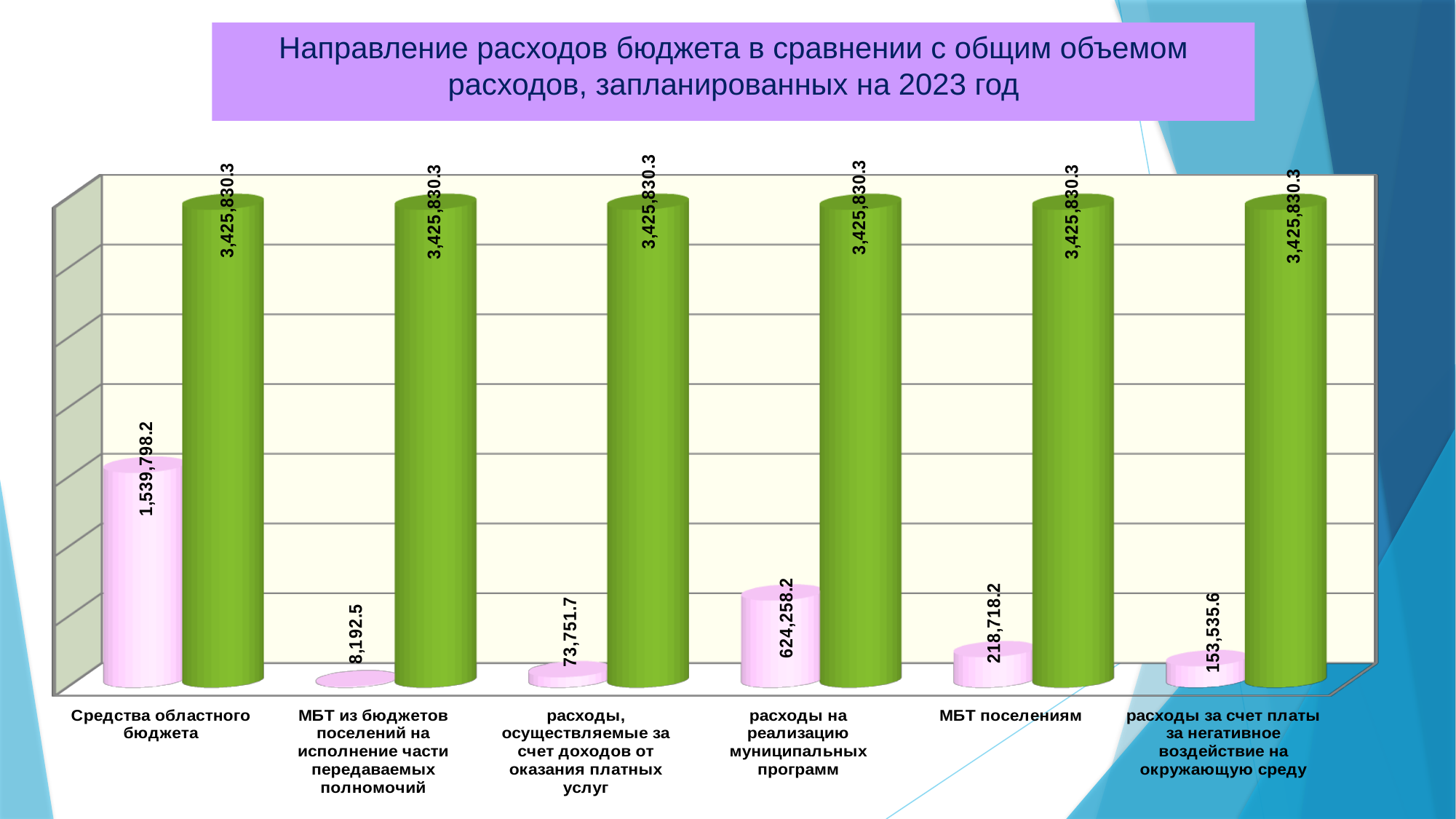
What value is shown on the green bar for "МБТ из бюджетов поселений на исполнение части передаваемых полномочий"? 3,425,830.3 What is the difference between the green bar and the pink bar for "Средства областного бюджета"? 1,886,032.1 Which pink bar is larger: "МБТ поселениям" or "расходы, осуществляемые за счет доходов от оказания платных услуг"? МБТ поселениям What is the value of the pink bar for "расходы за счет платы за негативное воздействие на окружающую среду"? 153,535.6 What is the value of the pink bar for "МБТ поселениям"? 218,718.2 What is the difference between the pink bars for "расходы на реализацию муниципальных программ" and "МБТ поселениям"? 405,540.0 Which category has the lowest pink bar? МБТ из бюджетов поселений на исполнение части передаваемых полномочий What is the value of the pink bar for "Средства областного бюджета"? 1,539,798.2 What is the value of the pink bar for "расходы на реализацию муниципальных программ"? 624,258.2 Which category has the highest pink bar? Средства областного бюджета How many categories are shown on the x axis of the chart? 6 What kind of chart is shown on the slide? Bar chart